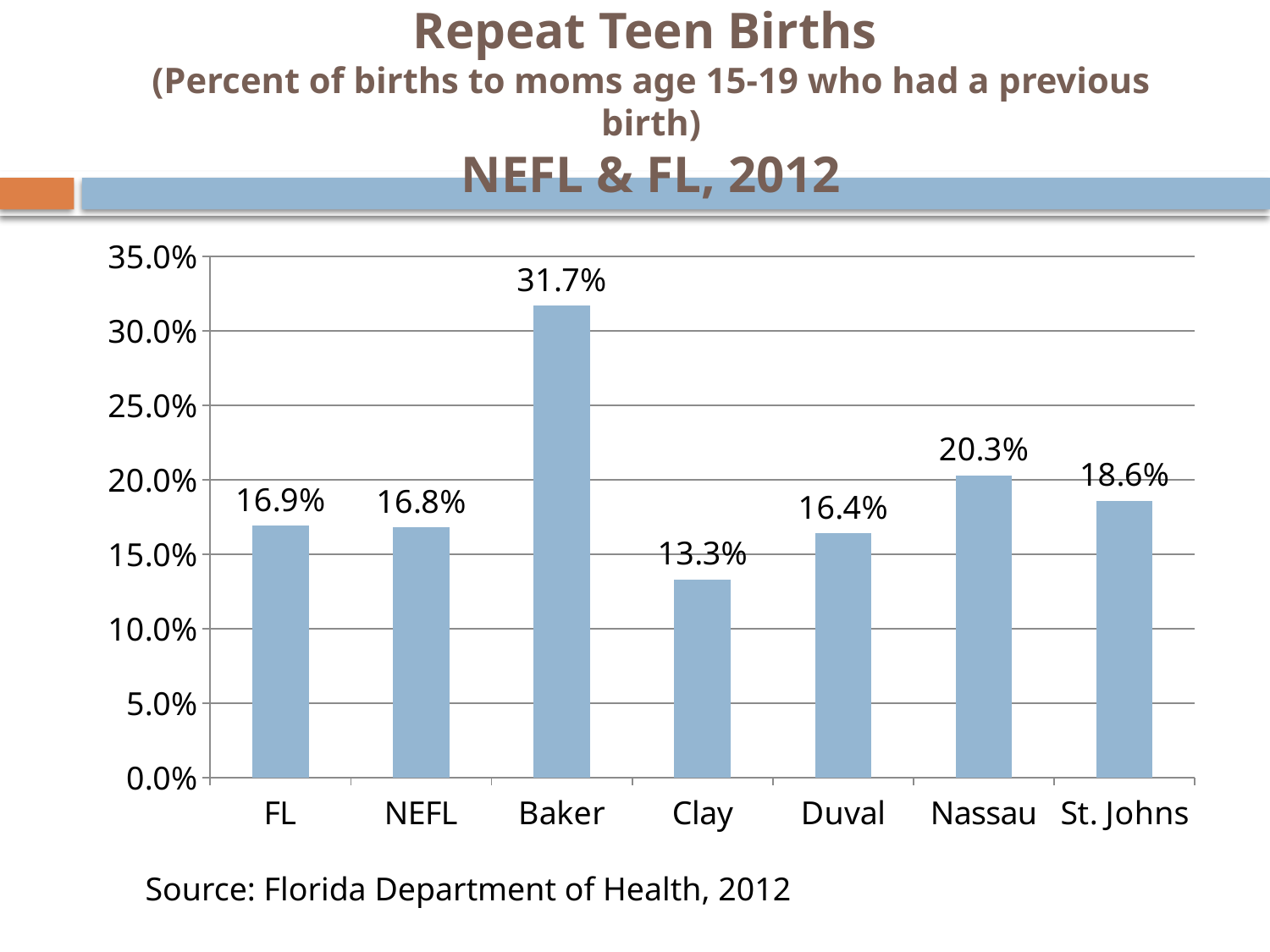
What is the repeat teen birth percentage for Clay? 13.3% How many categories are shown on the x axis of the chart? 7 Which has a higher repeat teen birth percentage, St. Johns or Duval? St. Johns What is the repeat teen birth percentage for Baker? 31.7% What kind of chart is shown on the slide? Bar chart What is the repeat teen birth percentage for FL? 16.9% What is the difference between the repeat teen birth percentages for Baker and Clay? 18.4% What is the difference between the repeat teen birth percentages for Nassau and Duval? 3.9% Which category has the lowest repeat teen birth percentage? Clay Which category has the highest repeat teen birth percentage? Baker What is the repeat teen birth percentage for Nassau? 20.3% Is the value for Baker greater or less than 30.0%? greater